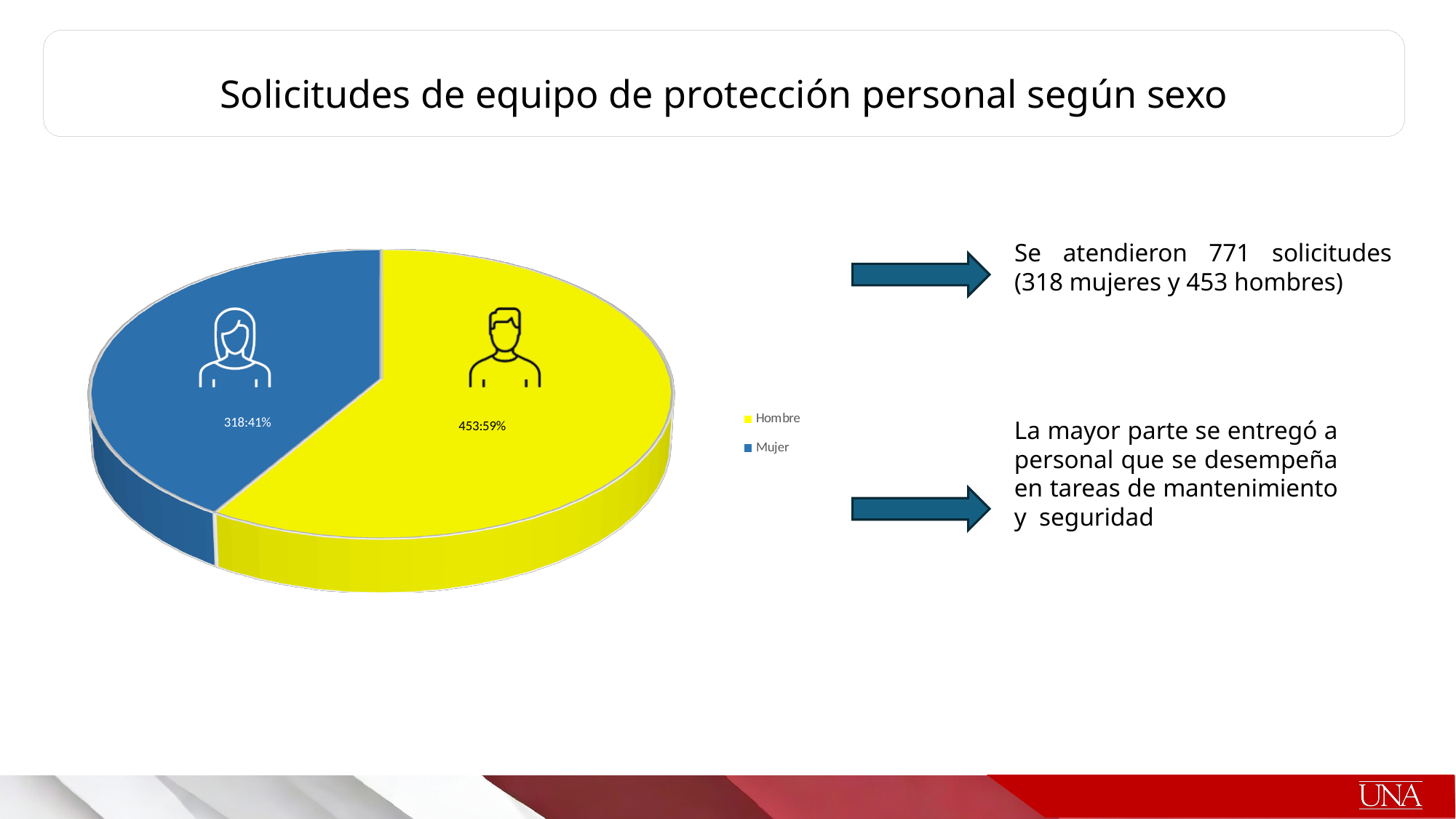
What is the value shown for Mujer? 318 What kind of chart is shown on the slide? pie chart What percentage share of the pie does Mujer have? 41% Which colour represents Mujer in the pie chart? blue Which category has the smallest slice? Mujer Which category has the largest slice? Hombre What is the difference between the Hombre and Mujer values? 135 How many slices does the pie chart have? 2 What percentage share of the pie does Hombre have? 59% Which is larger, the value for Hombre or the value for Mujer? Hombre What is the value shown for Hombre? 453 How many entries does the legend list? 2